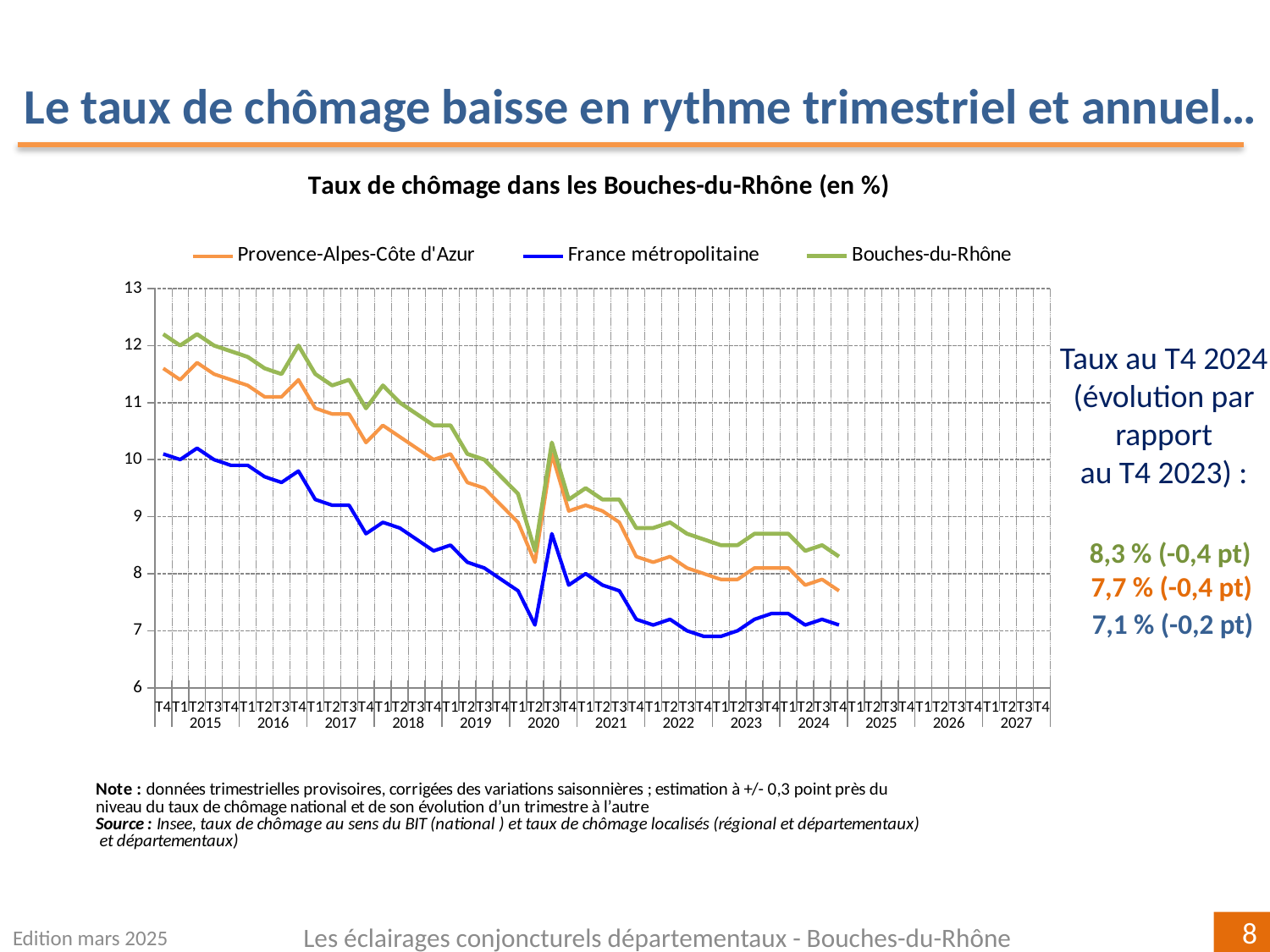
Overall, do the unemployment rates rise or fall between 2014 and 2024? fall Which series is drawn in blue? France métropolitaine Is the value for France métropolitaine at T4 2022 greater or less than 8? less Which series has the highest values across the whole period? Bouches-du-Rhône What is the title of the chart? Taux de chômage dans les Bouches-du-Rhône (en %) What is the difference between the Bouches-du-Rhône rate and the France métropolitaine rate at T4 2024? 1,2 pt What is the unemployment rate for Provence-Alpes-Côte d'Azur at T4 2024? 7,7 % What is the unemployment rate for France métropolitaine at T4 2024? 7,1 % How many series does the legend list? 3 By how much did the Bouches-du-Rhône rate change between T4 2023 and T4 2024? -0,4 pt What kind of chart is shown on the slide? line chart What is the unemployment rate for Bouches-du-Rhône at T4 2024? 8,3 %